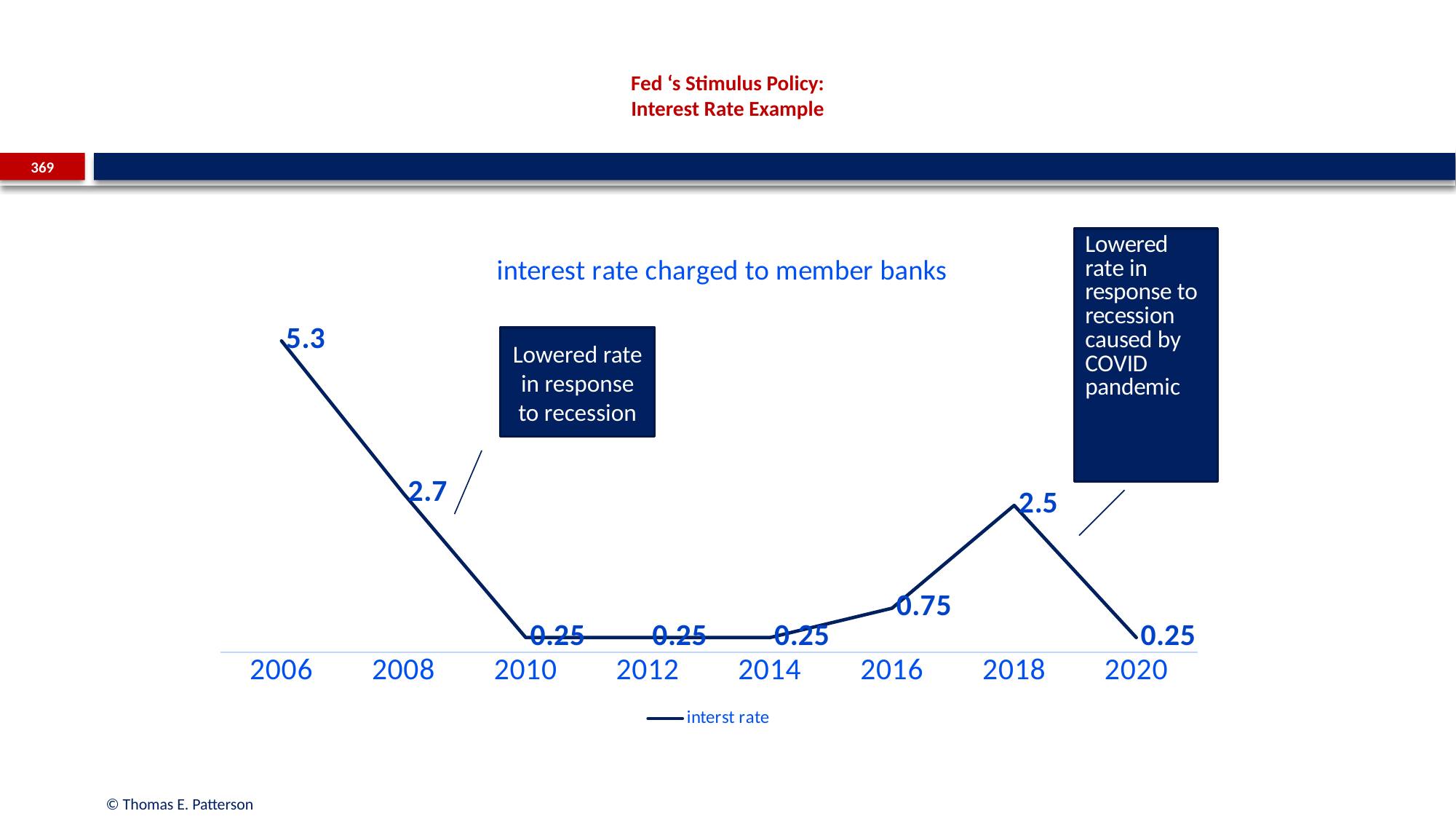
What is the interest rate charged to member banks in 2016? 0.75 Which is larger, the interest rate in 2008 or in 2018? 2008 What is the interest rate charged to member banks in 2006? 5.3 What is the difference between the interest rate in 2006 and in 2008? 2.6 What is the interest rate charged to member banks in 2018? 2.5 Which year has the highest interest rate on the chart? 2006 What kind of chart is shown on the slide? line chart Does the interest rate rise or fall from 2006 to 2010? fall How many years are plotted on the chart? 8 How many series does the legend list? 1 What is the difference between the interest rate in 2018 and in 2020? 2.25 What is the title of the chart? interest rate charged to member banks